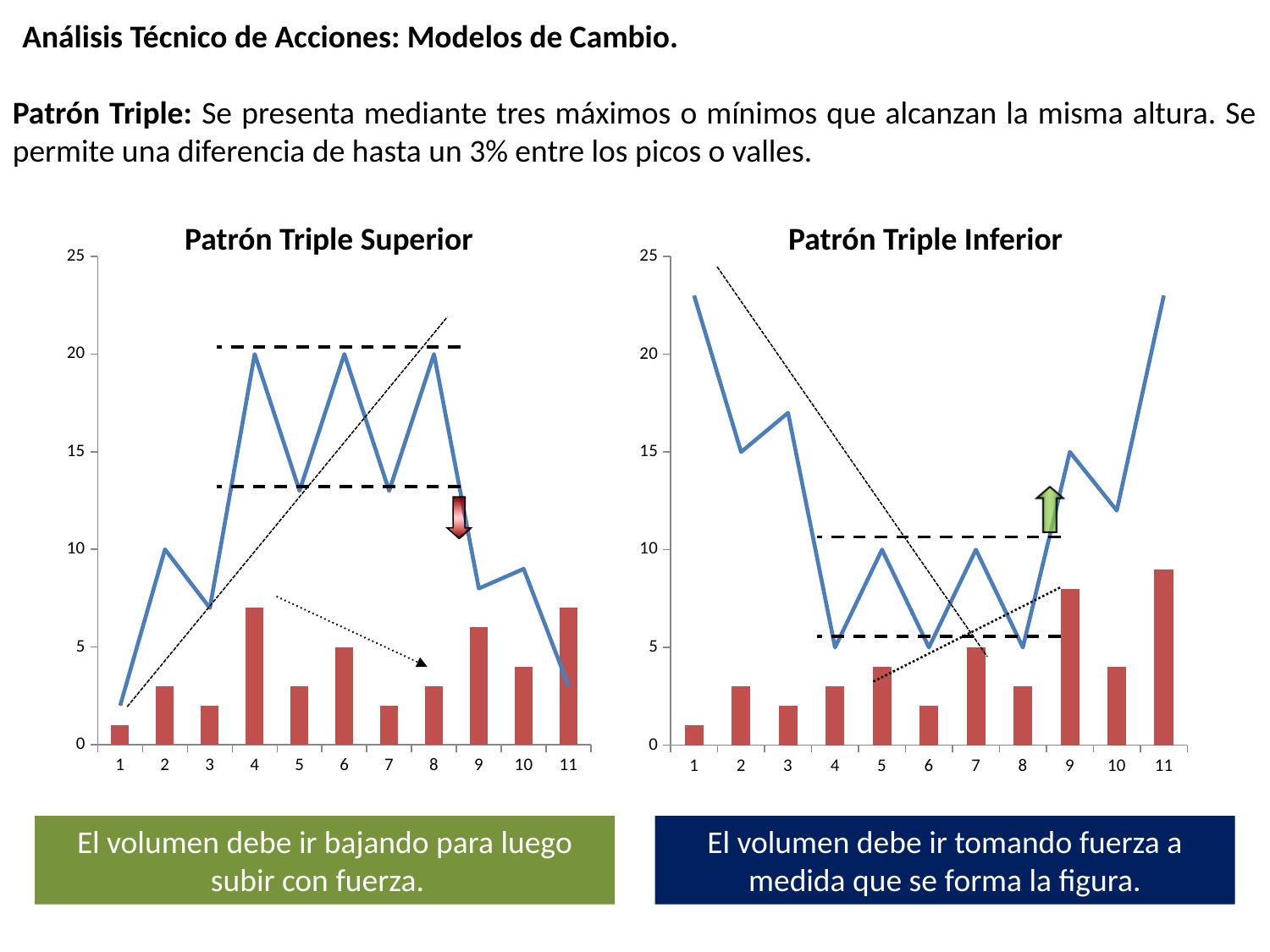
In the 'Patrón Triple Inferior' chart, what value does the line reach at point 2? 15 What is the title of the chart on the right side of the slide? Patrón Triple Inferior In the 'Patrón Triple Superior' chart, what value does the line reach at point 4? 20 In the 'Patrón Triple Inferior' chart, is the line value at point 3 greater or less than 15? greater What kind of chart is the 'Patrón Triple Superior' chart? A combined bar and line chart In the 'Patrón Triple Inferior' chart, which category has the highest bar? 11 In the 'Patrón Triple Inferior' chart, do the bars generally rise or fall from category 1 to category 11? Rise In the 'Patrón Triple Superior' chart, is the bar for category 9 greater or less than 5? greater In the 'Patrón Triple Inferior' chart, which bar is taller, category 10 or category 11? Category 11 How many x-axis categories does the 'Patrón Triple Inferior' chart have? 11 In the 'Patrón Triple Superior' chart, which bar is taller, category 4 or category 5? Category 4 In the 'Patrón Triple Superior' chart, which category has the lowest bar? 1